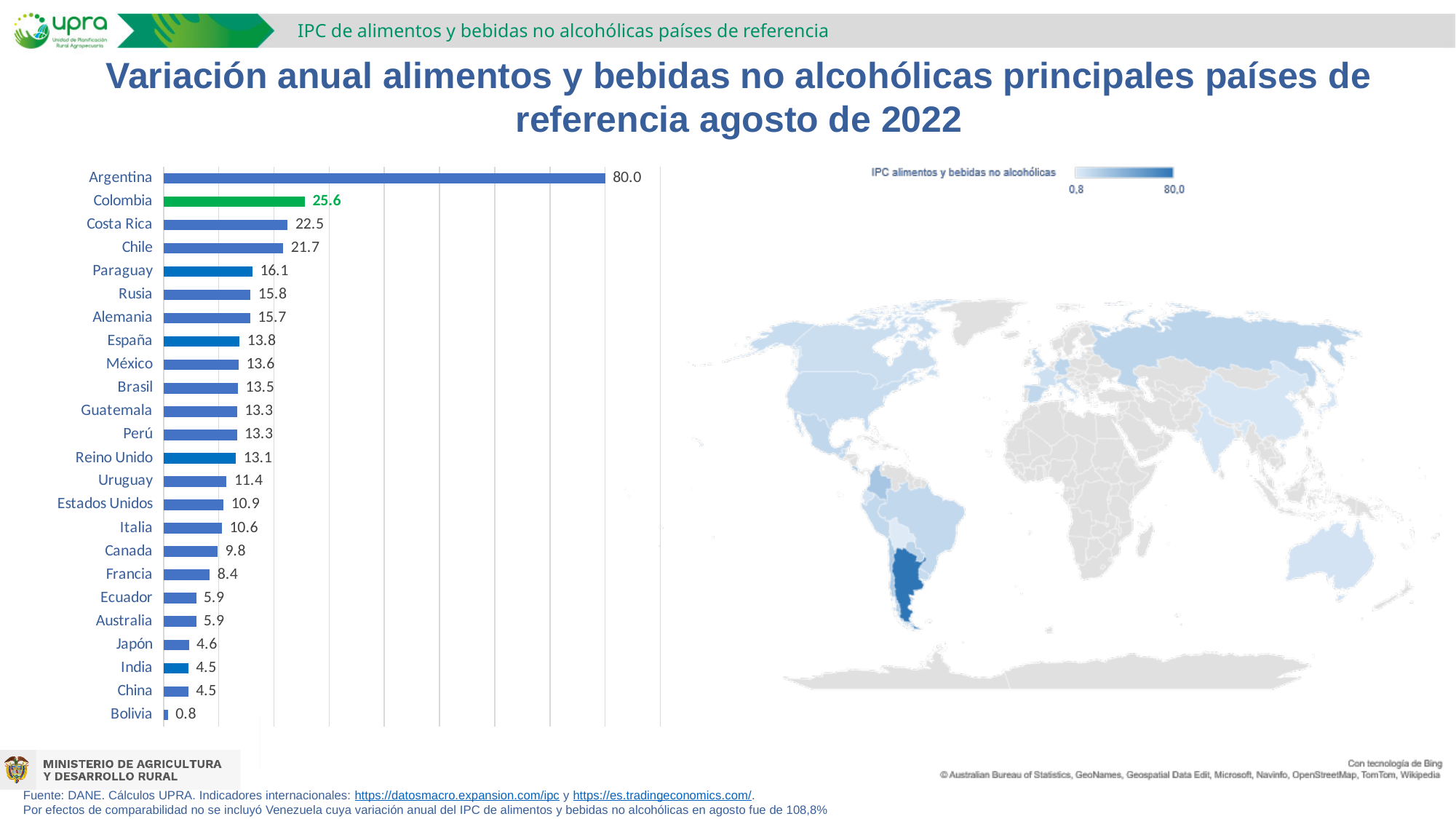
In the bar chart on the left, how many countries are shown? 24 What kind of chart is shown on the left side of the slide? Bar chart What kind of chart is shown on the right side of the slide? Map chart In the bar chart on the left, which country's bar is coloured green instead of blue? Colombia In the bar chart on the left, what is the difference between the values for Argentina and Colombia? 54.4 In the bar chart on the left, what is the value for Colombia? 25.6 In the bar chart on the left, what is the difference between the values for Costa Rica and Chile? 0.8 In the bar chart on the left, which country has the lowest value? Bolivia In the bar chart on the left, what is the value for Paraguay? 16.1 In the bar chart on the left, which country has the highest value? Argentina In the bar chart on the left, which has a larger value, Rusia or Uruguay? Rusia In the bar chart on the left, what is the value for Estados Unidos? 10.9